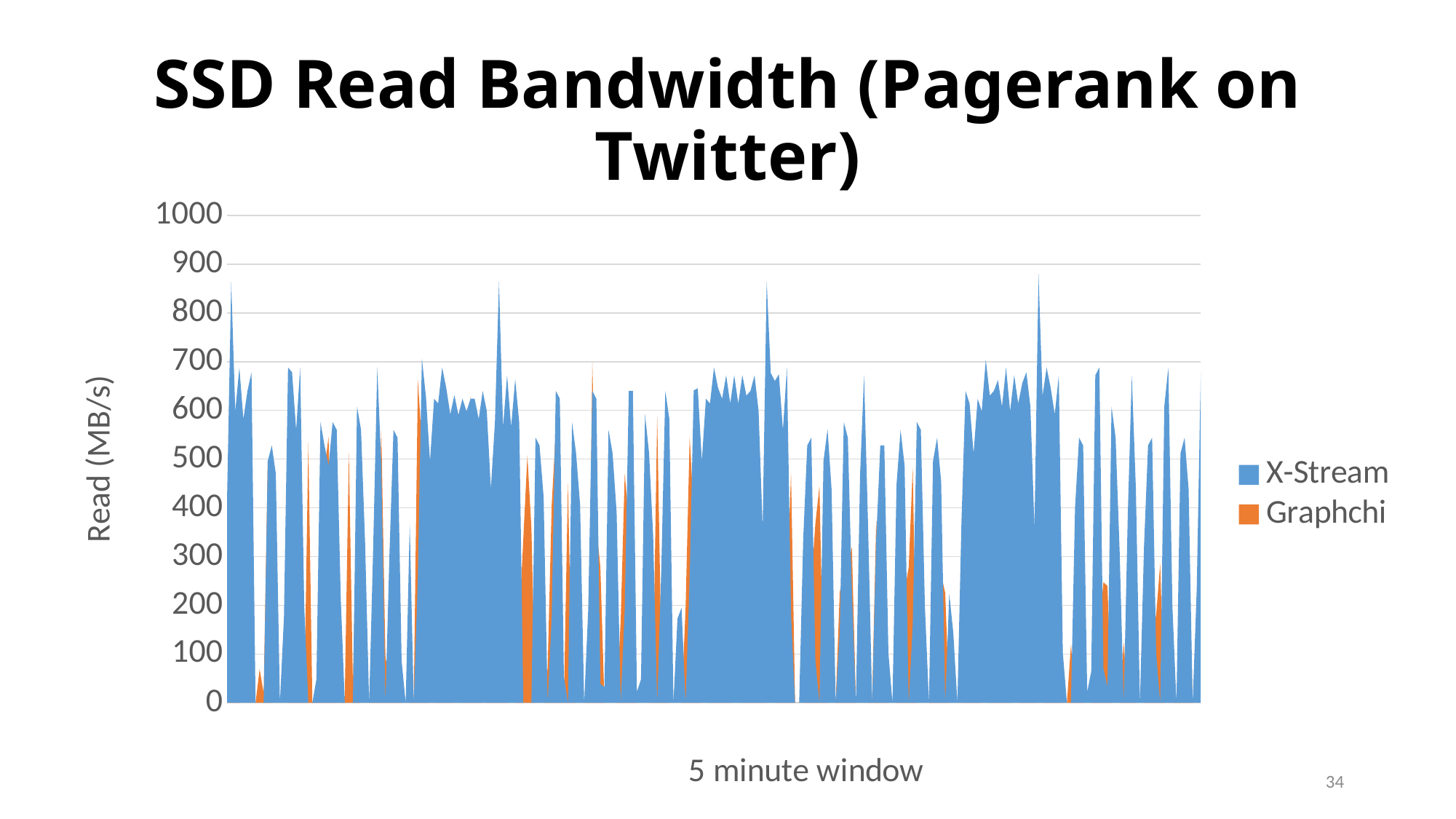
What kind of chart is shown on the slide? Area chart Is the highest value reached by X-Stream greater or less than 1000? less Which series has the highest value plotted on the chart? X-Stream What label is shown on the vertical axis? Read (MB/s) What is the title of the chart? SSD Read Bandwidth (Pagerank on Twitter) Is the highest value reached by Graphchi greater or less than 800? less Is the highest value reached by X-Stream greater or less than 800? greater How many series does the legend list? 2 Which series reaches the higher peak value, X-Stream or Graphchi? X-Stream